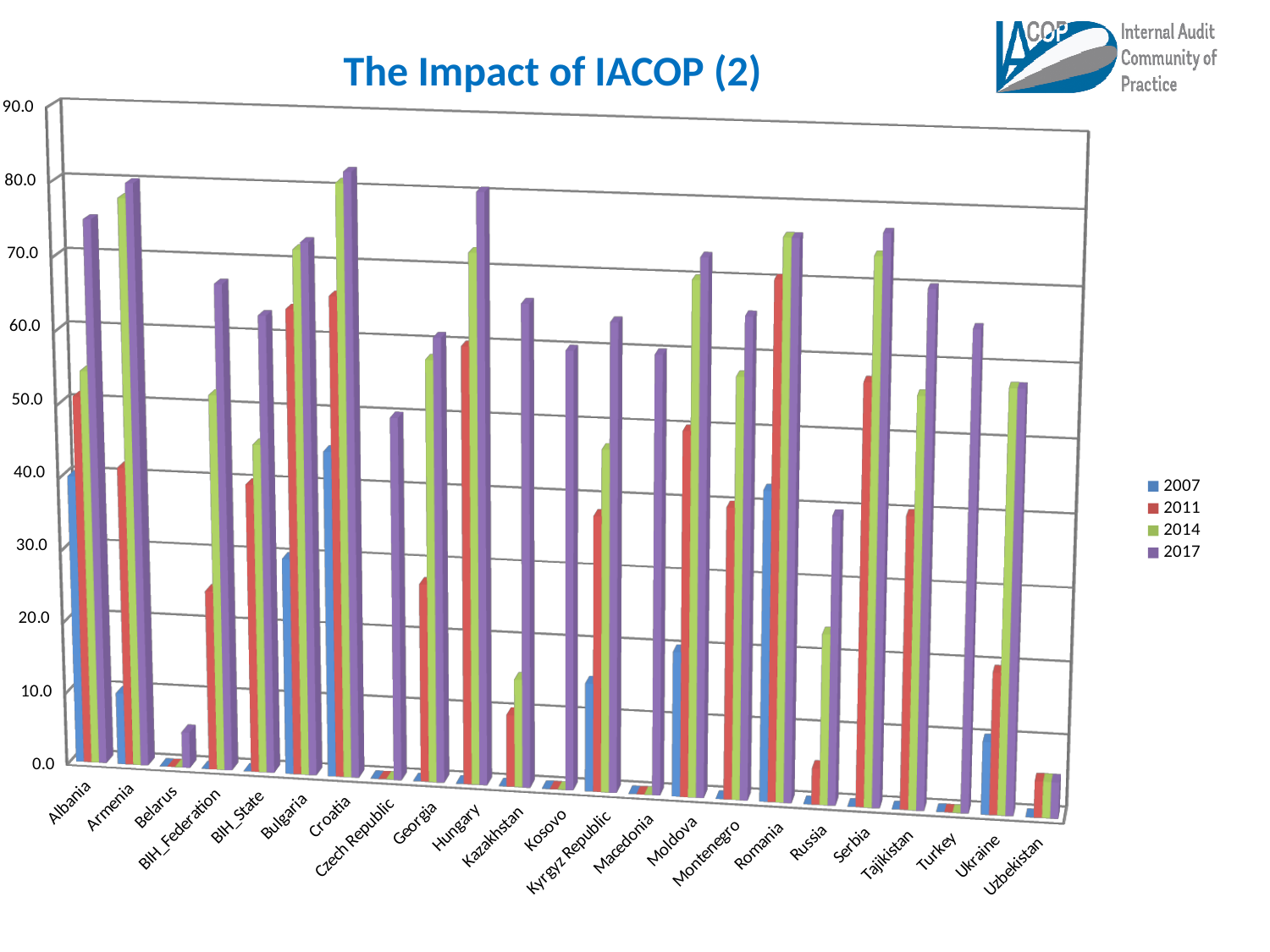
Do the values for Albania rise or fall from 2007 to 2017? rise For Albania, which year has the highest value? 2017 Is the 2011 value for Georgia greater or less than 30? less Is the 2017 value for Belarus greater or less than 10? less What is the title of the chart? The Impact of IACOP (2) Is the 2011 value for Romania greater or less than 60? greater Which is larger for 2017: the value for Albania or the value for Belarus? Albania How many series does the legend list? 4 What kind of chart is shown on the slide? bar chart How many countries are shown on the x axis? 23 Which year does the purple series represent? 2017